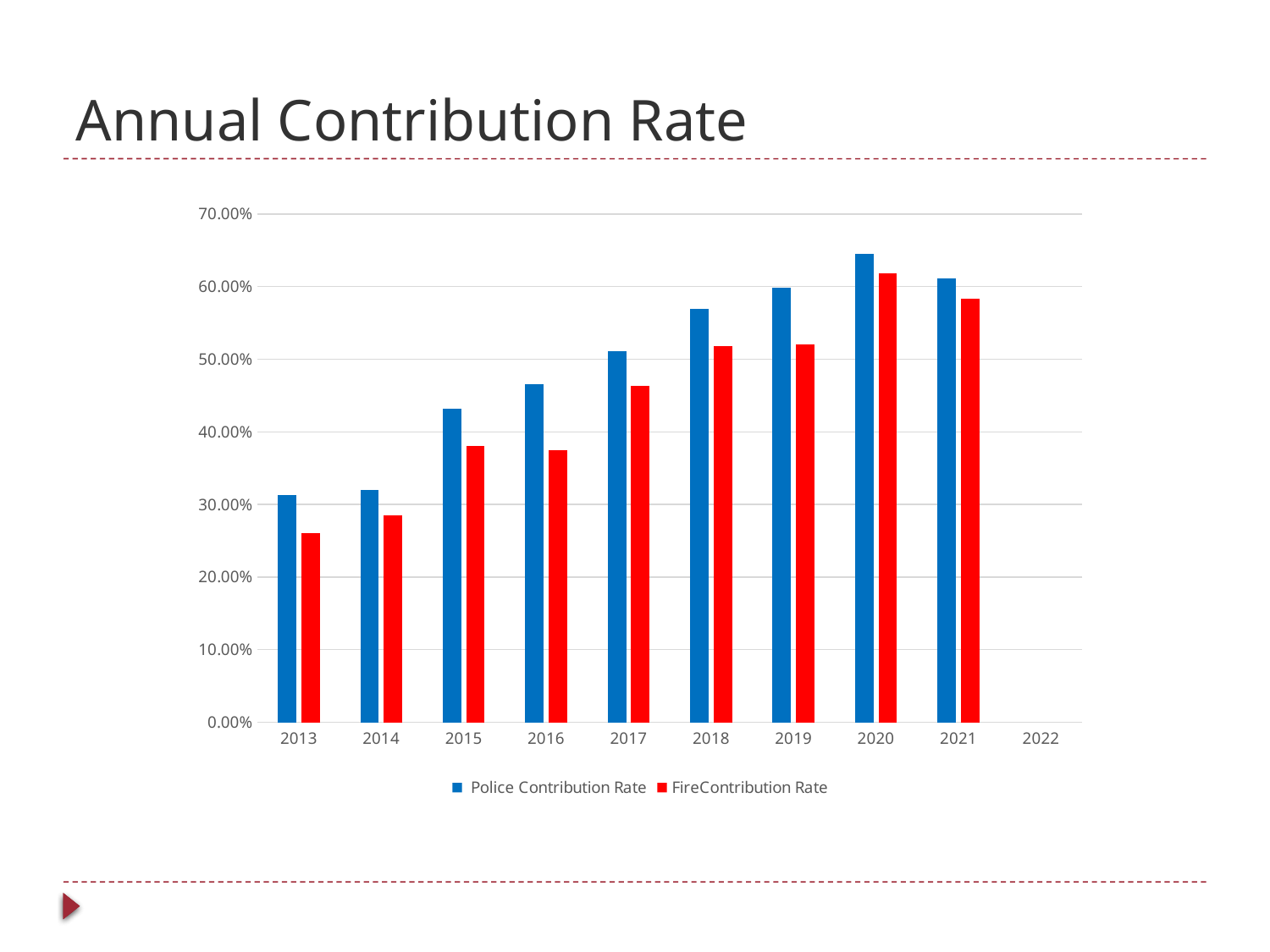
In which year is the Fire Contribution Rate highest? 2020 Is the Fire Contribution Rate for 2021 greater or less than 60.00%? less Is the Police Contribution Rate for 2018 greater or less than 50.00%? greater In which year is the Police Contribution Rate highest? 2020 Does the Police Contribution Rate generally rise or fall from 2013 to 2020? rise How many years are labelled on the x axis? 10 Is the Fire Contribution Rate for 2016 greater or less than 40.00%? less What kind of chart is shown on the slide? bar chart In which year is the Fire Contribution Rate lowest? 2013 How many series does the legend list? 2 What colour are the Fire Contribution Rate bars? red In 2017, which is larger, the Police Contribution Rate or the Fire Contribution Rate? Police Contribution Rate